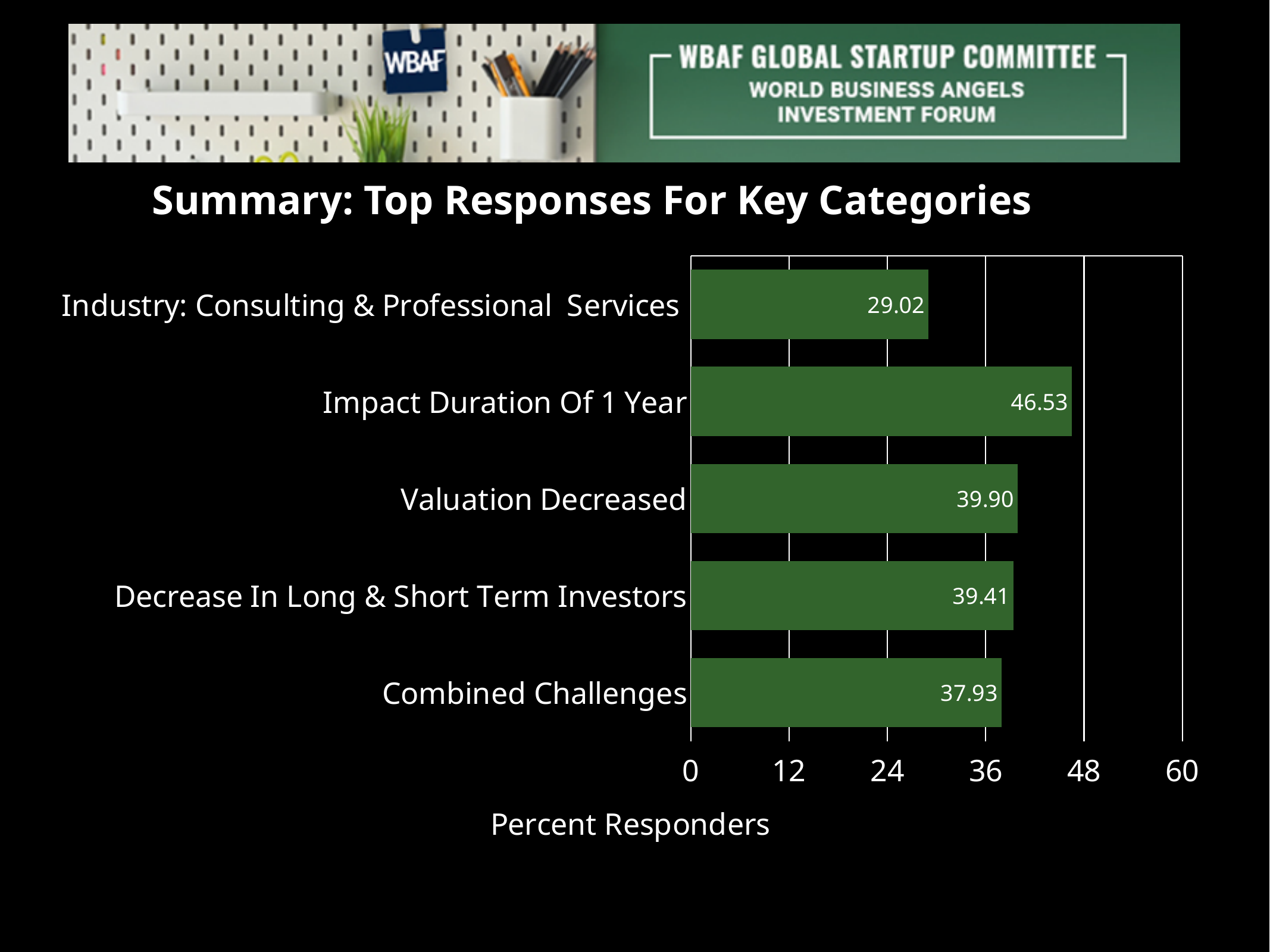
What is the difference between the values for Impact Duration Of 1 Year and Industry: Consulting & Professional Services? 17.51 How many categories are shown in the chart? 5 What is the value for Impact Duration Of 1 Year? 46.53 What is the value for Combined Challenges? 37.93 What is the value for Valuation Decreased? 39.90 Which is larger, the value for Valuation Decreased or the value for Combined Challenges? Valuation Decreased Which category has the lowest value? Industry: Consulting & Professional Services Is the value for Decrease In Long & Short Term Investors greater or less than 36? greater What is the label of the horizontal axis? Percent Responders What kind of chart is shown on the slide? bar chart Which category has the highest value? Impact Duration Of 1 Year What is the value for Industry: Consulting & Professional Services? 29.02